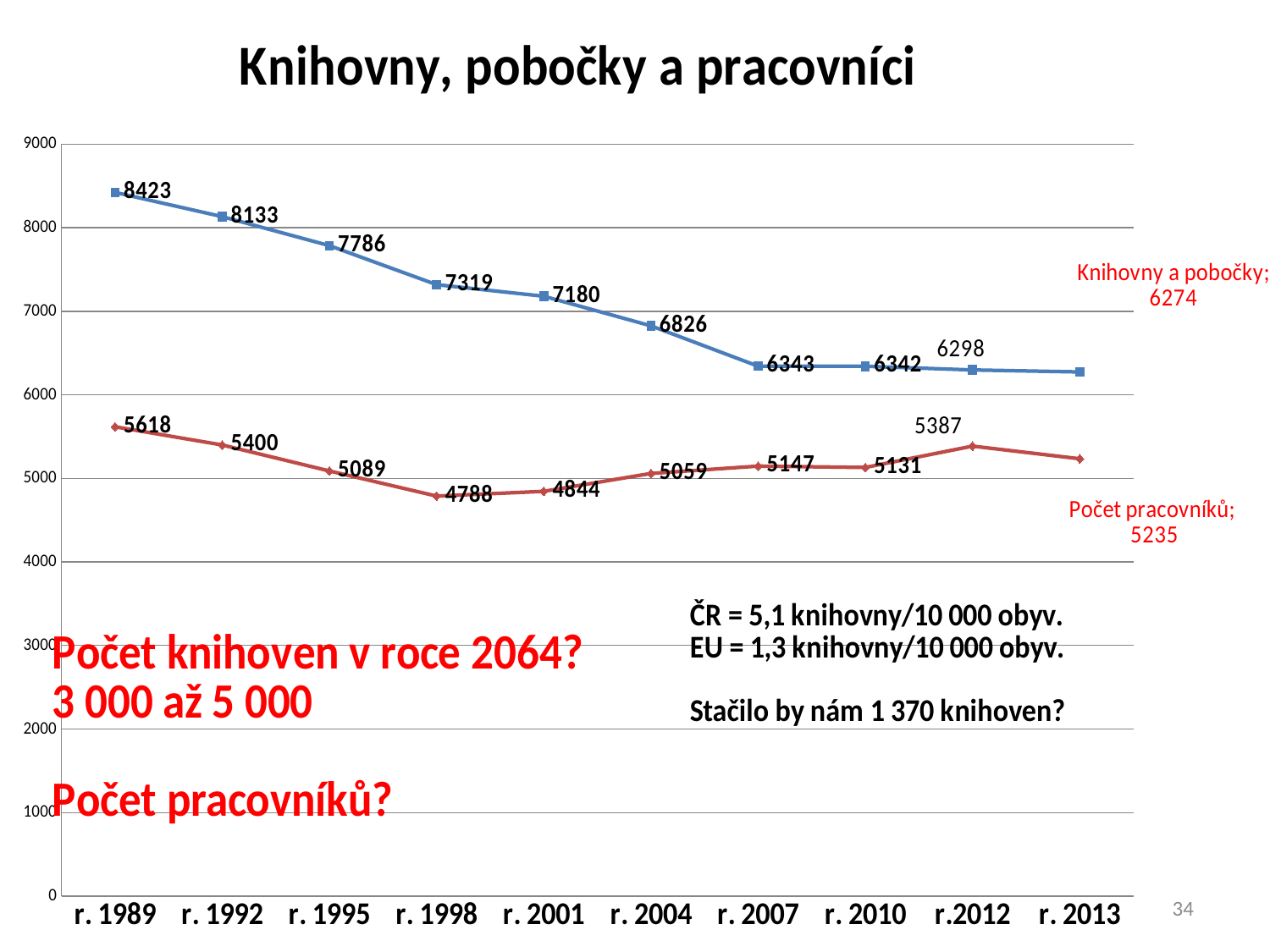
Which is larger: Počet pracovníků in r. 1989 or in r. 2013? r. 1989 What is the value of Knihovny a pobočky in r. 2013? 6274 How many data series does the chart plot? 2 How many years are shown on the x axis? 10 What type of chart is shown on the slide? line chart What is the value of Počet pracovníků in r. 1998? 4788 What is the value of Knihovny a pobočky in r. 1989? 8423 What is the difference between Knihovny a pobočky in r. 1989 and in r. 2013? 2149 Does Knihovny a pobočky rise or fall from r. 1989 to r. 2013? fall In which year is Počet pracovníků at its lowest? r. 1998 What is the value of Počet pracovníků in r.2012? 5387 In which year is Knihovny a pobočky at its highest? r. 1989